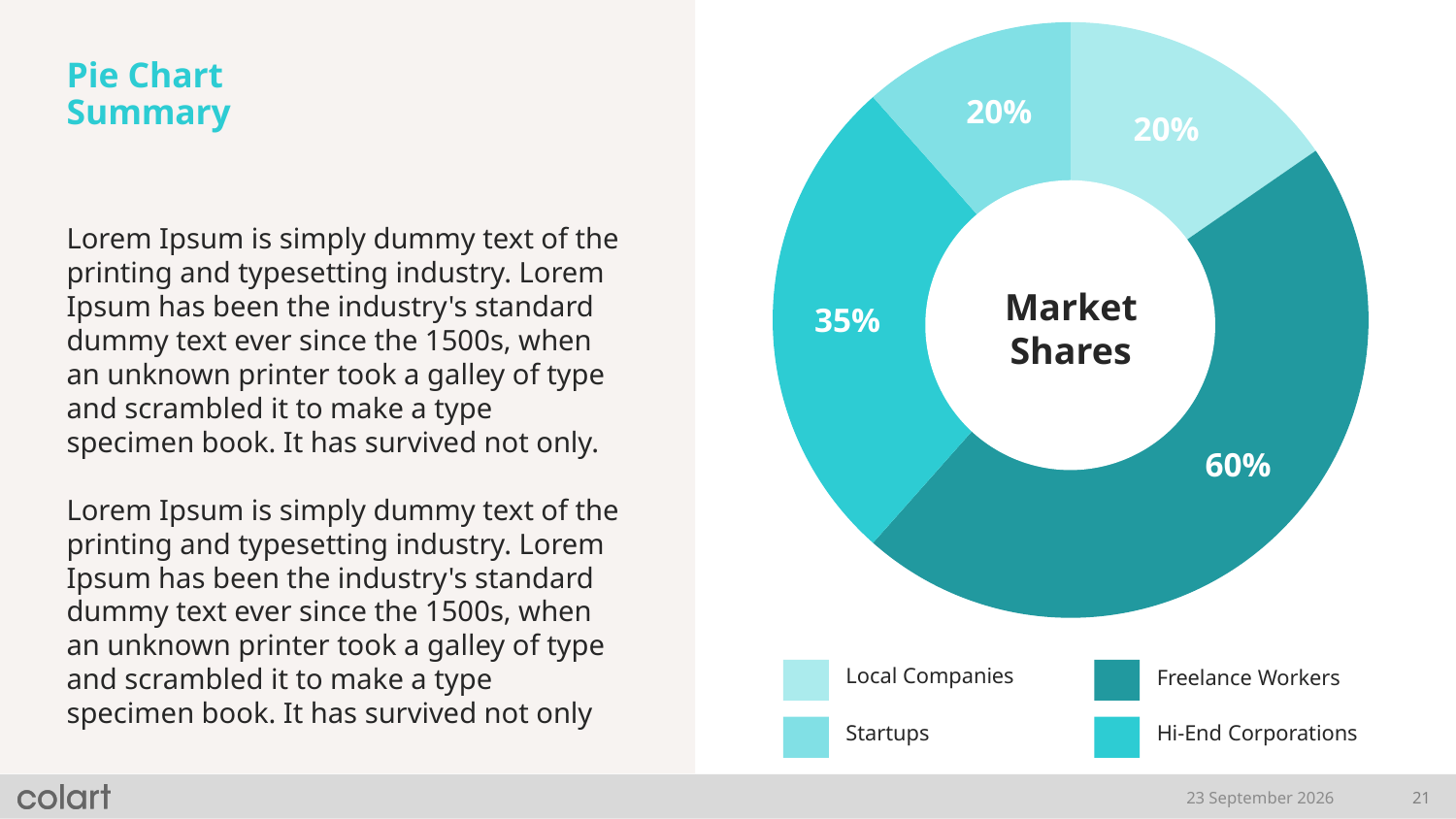
What percentage is labelled on the Startups slice? 20% What kind of chart is shown on the slide? Pie chart (donut) What percentage is labelled on the Local Companies slice? 20% What percentage is labelled on the Hi-End Corporations slice? 35% Which legend entry is shown with the darkest teal colour? Freelance Workers Which category has the largest slice? Freelance Workers What is the difference between the Hi-End Corporations percentage and the Startups percentage? 15% How many categories does the legend list? 4 What percentage is labelled on the Freelance Workers slice? 60% Which is larger, the Hi-End Corporations slice or the Local Companies slice? Hi-End Corporations What is the title shown in the centre of the chart? Market Shares What is the difference between the Freelance Workers percentage and the Hi-End Corporations percentage? 25%